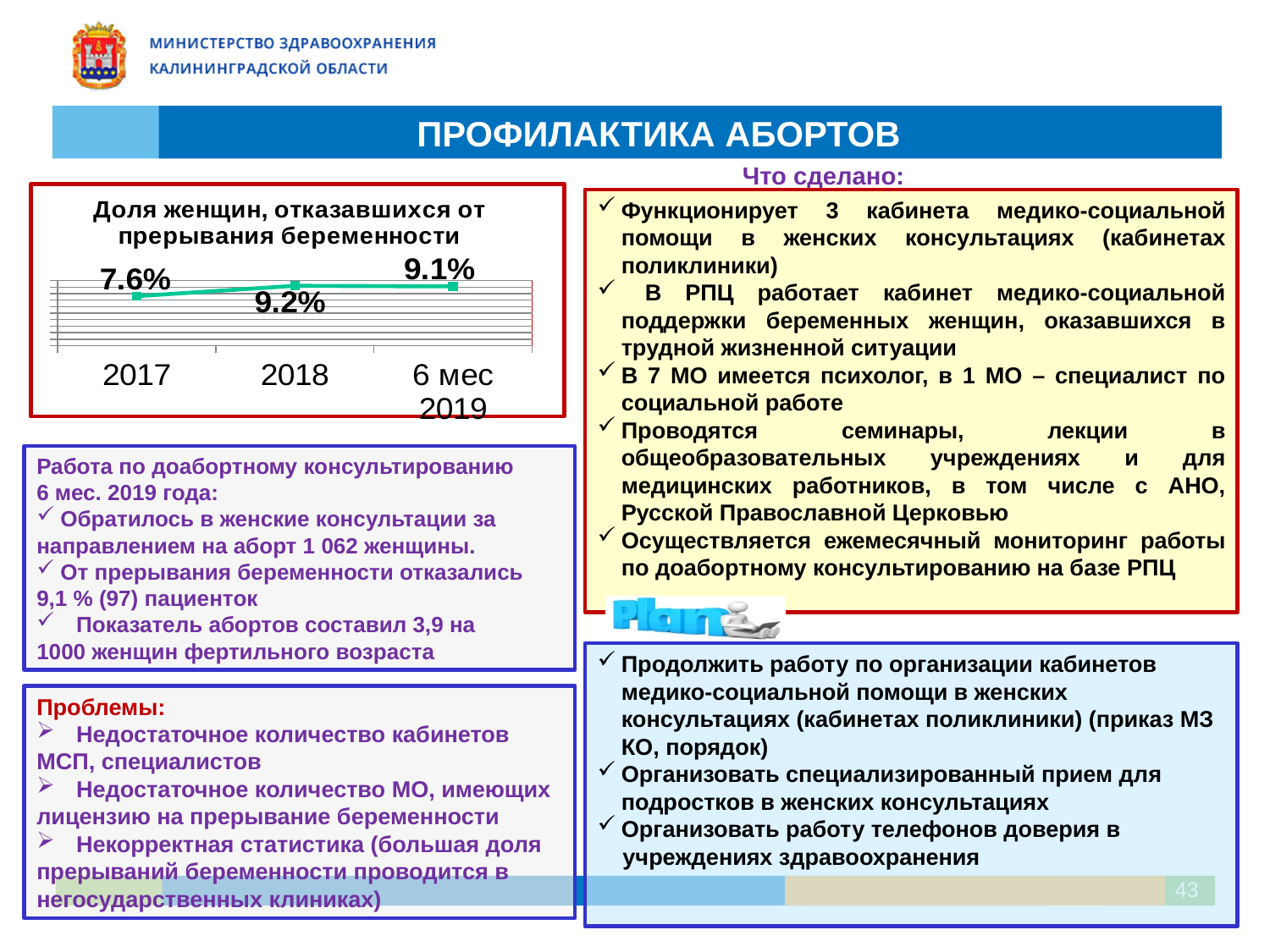
What is the difference between the values for 2018 and '6 мес 2019'? 0.1 percentage points Which category has the lowest value in the chart? 2017 Which category has the highest value in the chart? 2018 What is the title of the chart? Доля женщин, отказавшихся от прерывания беременности What is the value for '6 мес 2019' in the chart? 9.1% What is the value for 2018 in the chart? 9.2% How many categories are plotted on the x axis of the chart? 3 What kind of chart is shown on the slide? Line chart What is the difference between the values for 2018 and 2017? 1.6 percentage points Which is larger, the value for 2017 or the value for 2018? 2018 What is the value for 2017 in the chart 'Доля женщин, отказавшихся от прерывания беременности'? 7.6% Does the value rise or fall from 2017 to 2018? Rise